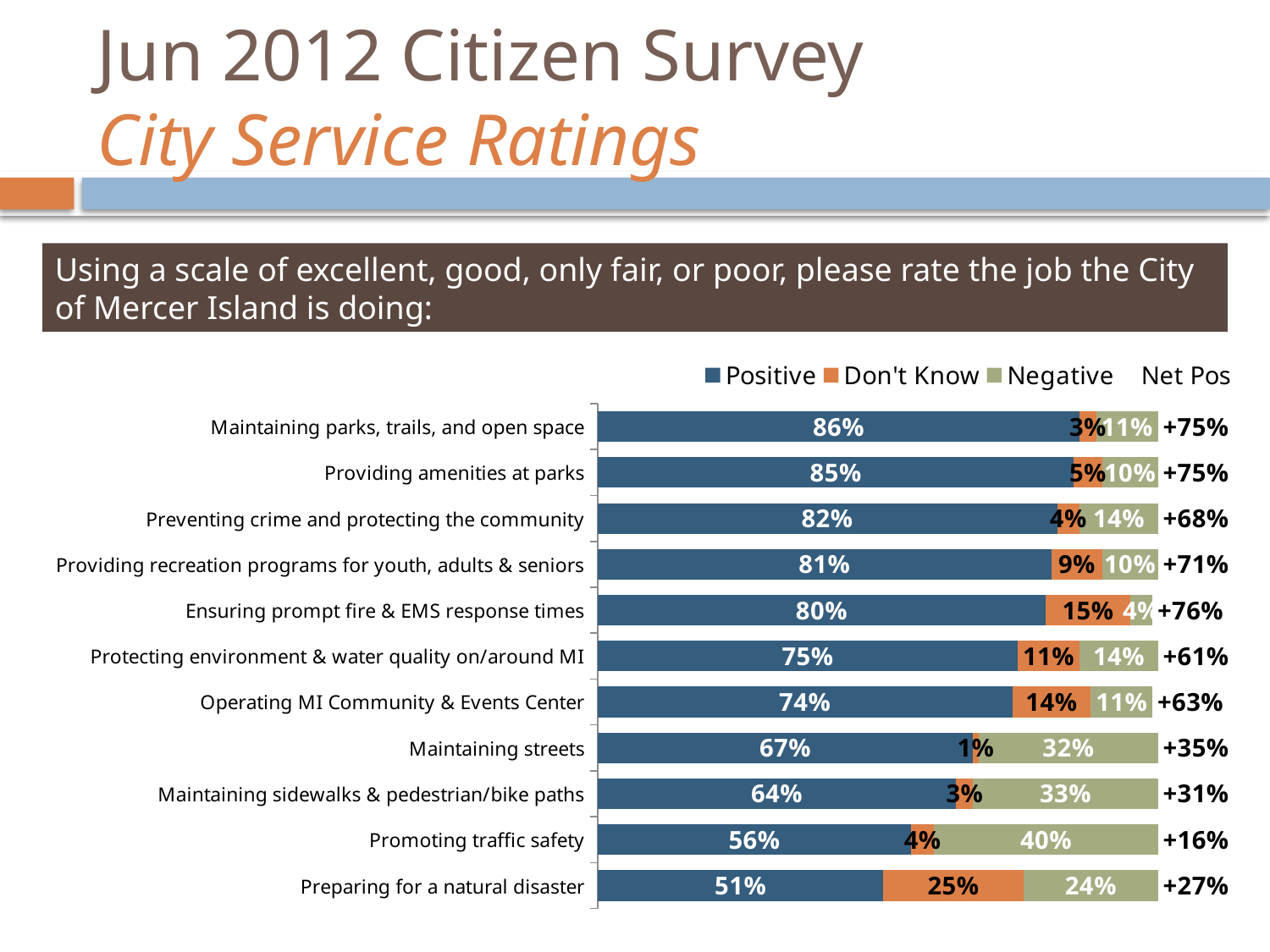
What is the Positive value for Maintaining streets? 67% What is the Don't Know value for Preparing for a natural disaster? 25% How many categories are shown in the chart? 11 How many series does the legend list? 3 What is the Negative value for Promoting traffic safety? 40% What is the difference between the Positive values for Providing amenities at parks and Promoting traffic safety? 29% Which has a larger Negative value, Maintaining streets or Operating MI Community & Events Center? Maintaining streets What is the Net Pos value for Ensuring prompt fire & EMS response times? +76% What kind of chart is shown on the slide? Stacked bar chart Which category has the lowest Net Pos value? Promoting traffic safety Which category has the lowest Positive value? Preparing for a natural disaster Which category has the highest Positive value? Maintaining parks, trails, and open space